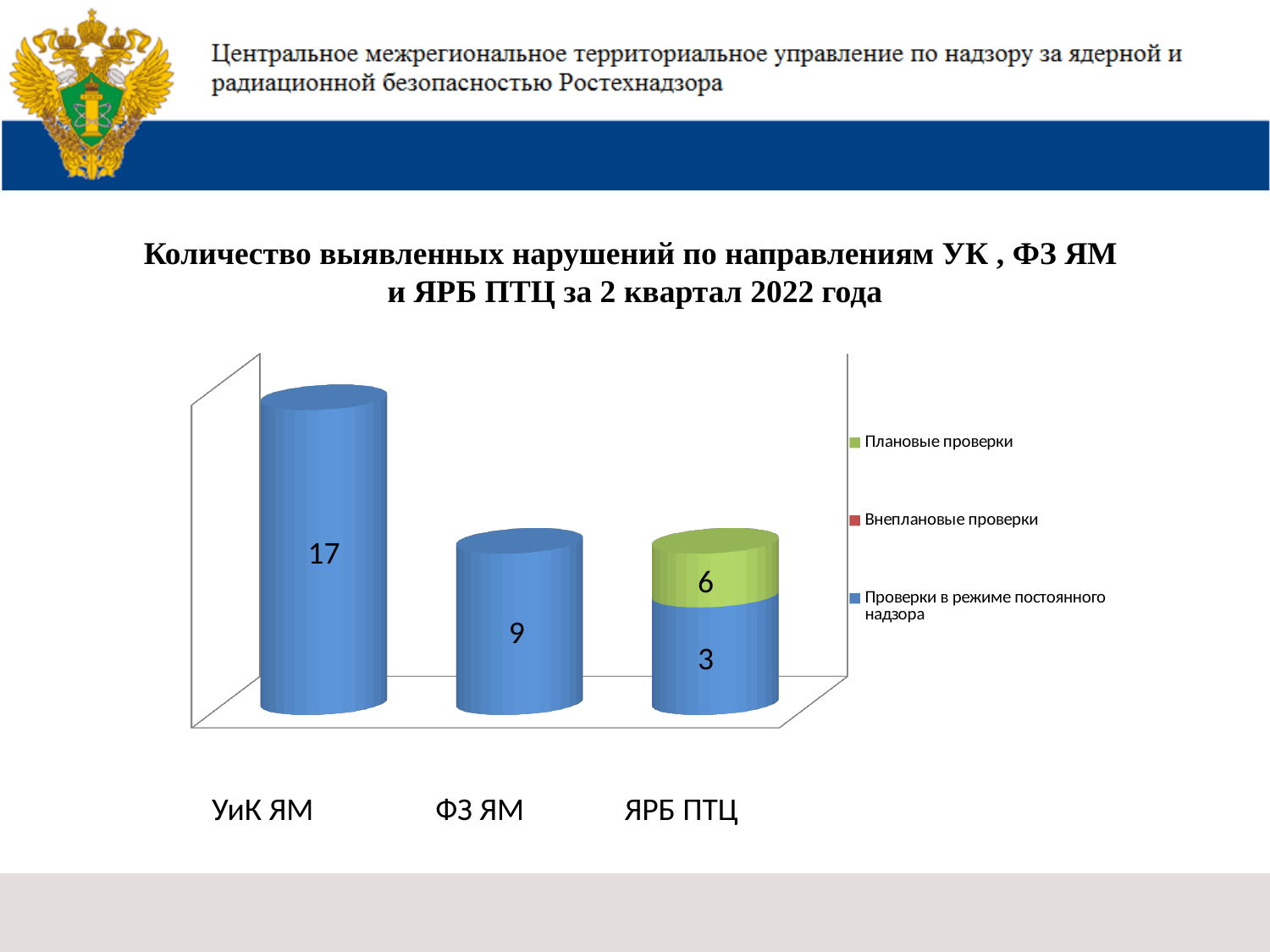
What is the difference between the Проверки в режиме постоянного надзора values for УиК ЯМ and ФЗ ЯМ? 8 What is the value for Проверки в режиме постоянного надзора in the ФЗ ЯМ category? 9 What kind of chart is shown on the slide? Bar chart What is the total of the stacked bar for ЯРБ ПТЦ? 9 Which category has the highest value for Проверки в режиме постоянного надзора? УиК ЯМ What is the value for Проверки в режиме постоянного надзора in the УиК ЯМ category? 17 Which category has the lowest value for Проверки в режиме постоянного надзора? ЯРБ ПТЦ How many series does the legend list? 3 How many categories are shown on the x axis? 3